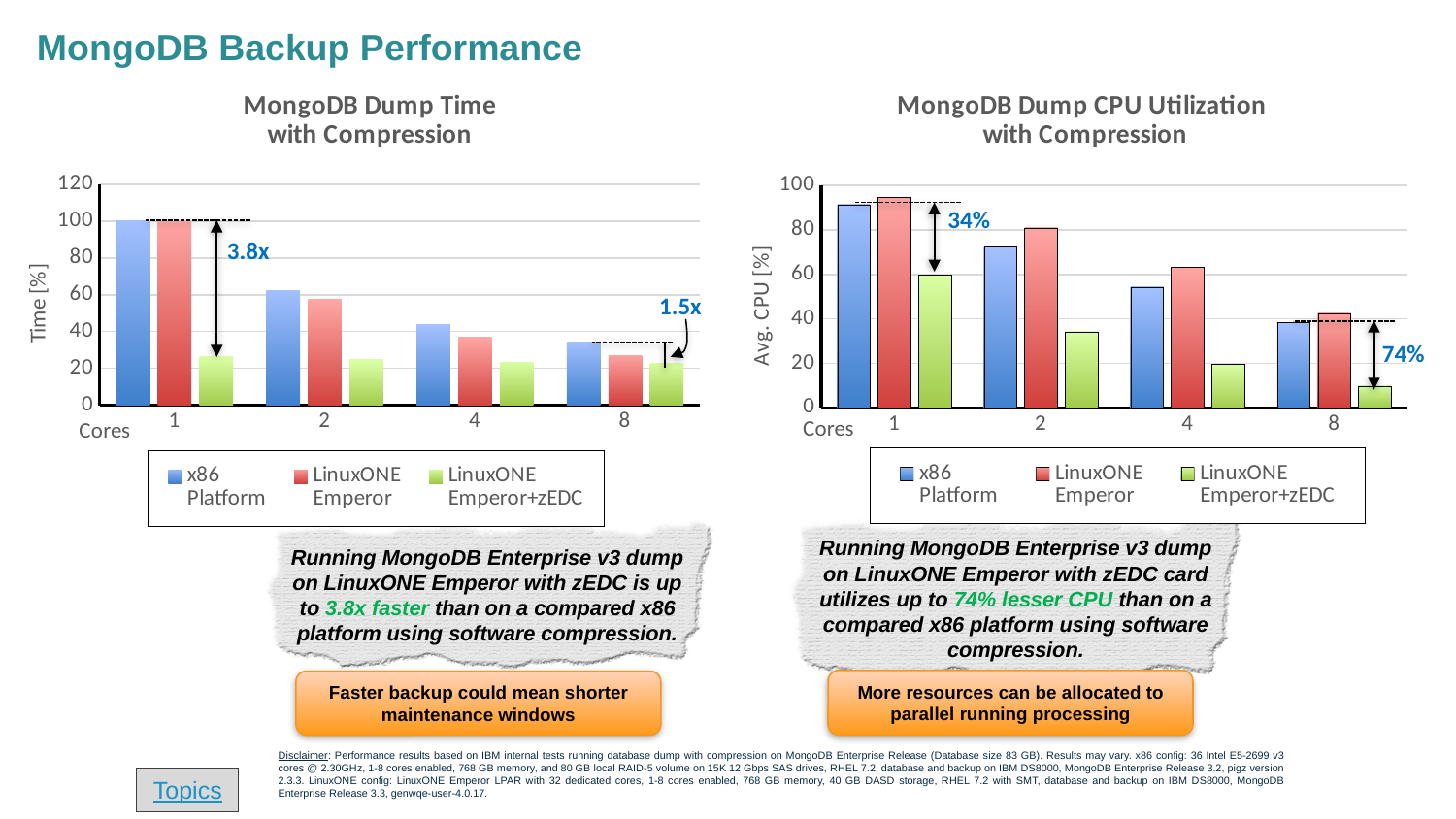
In the MongoDB Dump CPU Utilization with Compression chart, is the value for LinuxONE Emperor+zEDC at 2 cores greater or less than 40? less In the MongoDB Dump CPU Utilization with Compression chart, is the value for x86 Platform at 1 core greater or less than 80? greater In the MongoDB Dump Time with Compression chart, which is larger at 4 cores: x86 Platform or LinuxONE Emperor? x86 Platform In the MongoDB Dump CPU Utilization with Compression chart, which bar has the lowest value overall? LinuxONE Emperor+zEDC at 8 cores In the MongoDB Dump CPU Utilization with Compression chart, which is larger at 2 cores: x86 Platform or LinuxONE Emperor? LinuxONE Emperor How many core categories are shown on the x axis of the MongoDB Dump CPU Utilization with Compression chart? 4 In the MongoDB Dump Time with Compression chart, what is the value for x86 Platform at 1 core? 100 In the MongoDB Dump Time with Compression chart, how does the x86 Platform value change as the number of cores increases? It falls In the MongoDB Dump Time with Compression chart, is the value for LinuxONE Emperor+zEDC at 1 core greater or less than 40? less In the MongoDB Dump Time with Compression chart, which series has the lowest value at 1 core? LinuxONE Emperor+zEDC How many series does the legend of the MongoDB Dump Time with Compression chart list? 3